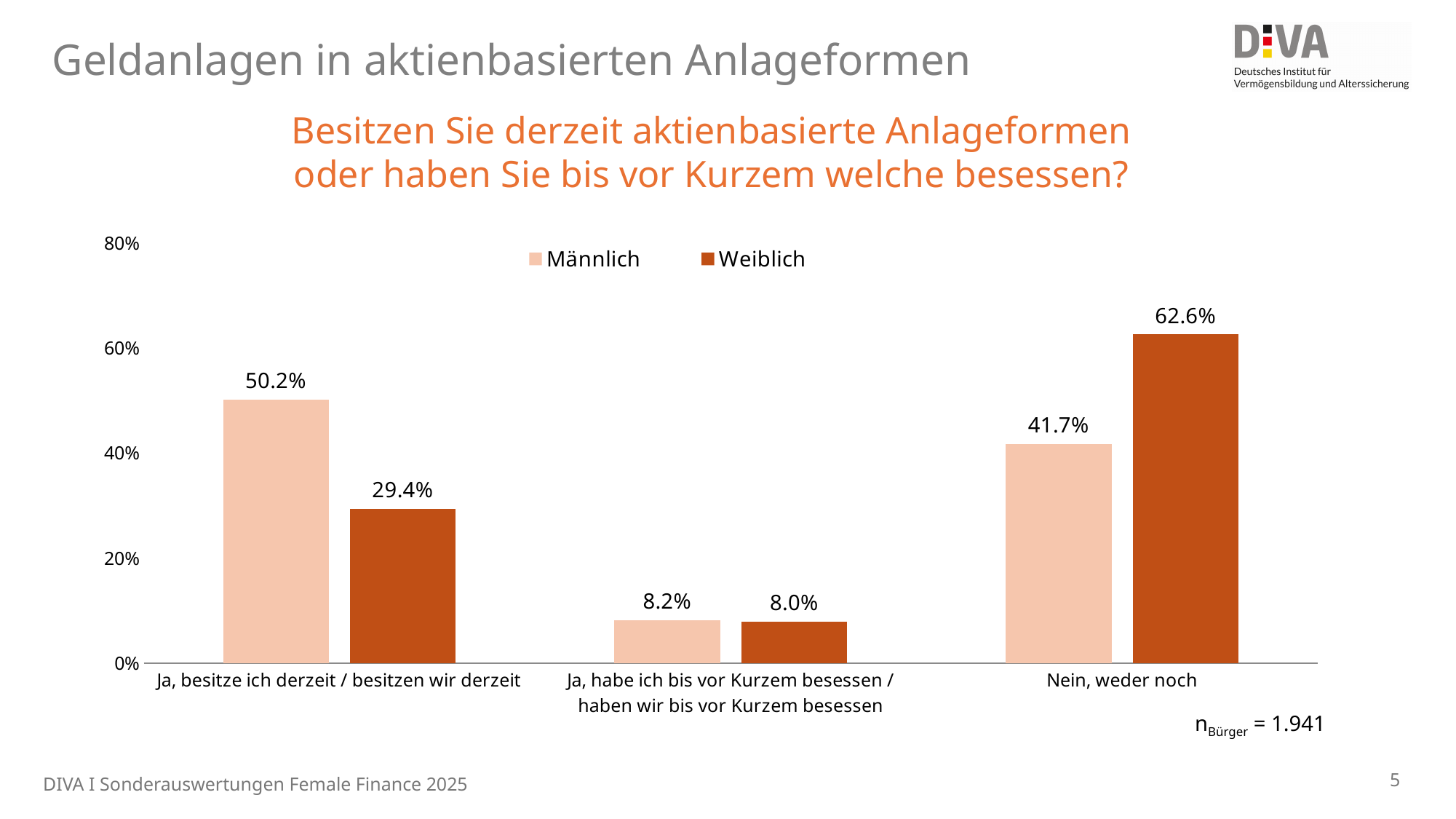
In the category "Nein, weder noch", which series has the larger value, Männlich or Weiblich? Weiblich What is the difference between the Männlich and Weiblich values in the category "Ja, besitze ich derzeit / besitzen wir derzeit"? 20.8% What kind of chart is shown on the slide? bar chart What is the difference between the Weiblich and Männlich values in the category "Nein, weder noch"? 20.9% What is the value for Weiblich in the category "Ja, habe ich bis vor Kurzem besessen / haben wir bis vor Kurzem besessen"? 8.0% Which category has the lowest value for Männlich? Ja, habe ich bis vor Kurzem besessen / haben wir bis vor Kurzem besessen How many series does the legend list? 2 Is the Männlich value for "Nein, weder noch" greater or less than 40%? greater What is the value for Weiblich in the category "Nein, weder noch"? 62.6% How many categories are shown on the x axis? 3 Which category has the highest value for Weiblich? Nein, weder noch What is the value for Männlich in the category "Ja, besitze ich derzeit / besitzen wir derzeit"? 50.2%